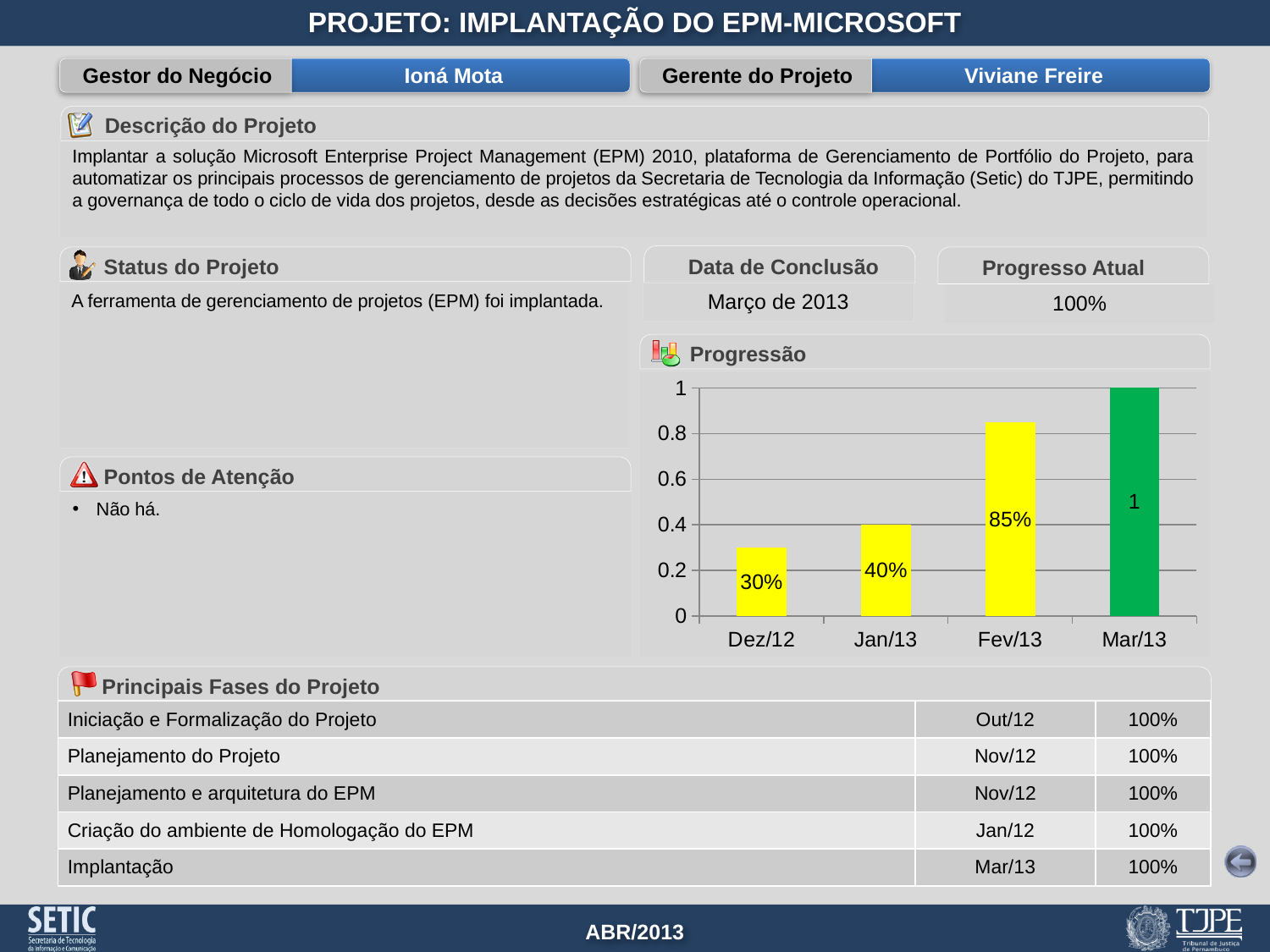
In the Progressão chart, what is the value shown for Fev/13? 85% In the Progressão chart, which month has the highest bar? Mar/13 In the Progressão chart, what data label is shown on the Mar/13 bar? 1 What kind of chart is the Progressão chart? bar chart In the Progressão chart, which month has the lowest bar? Dez/12 In the Progressão chart, do the values rise or fall from Dez/12 to Mar/13? rise In the Progressão chart, what is the value shown for Dez/12? 30% In the Progressão chart, what is the difference between the values for Fev/13 and Jan/13? 45% In the Progressão chart, what colour is the Mar/13 bar? green In the Progressão chart, which is larger, the value for Jan/13 or the value for Dez/12? Jan/13 How many months are shown on the x axis of the Progressão chart? 4 In the Progressão chart, is the value for Fev/13 greater or less than 0.8? greater